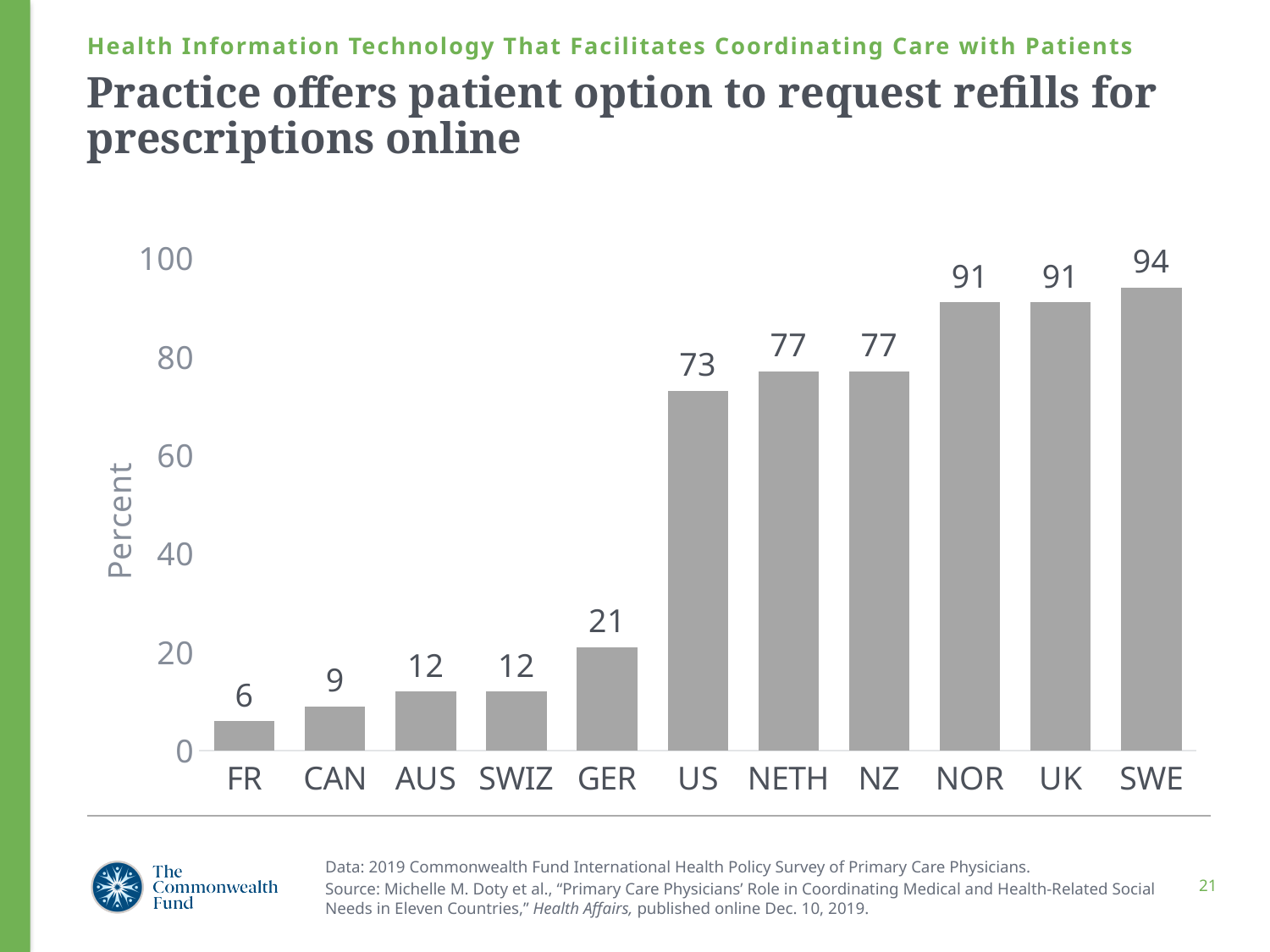
Which country has the lowest value? FR Which country has the highest value? SWE What is the value for US? 73 How many countries are shown on the x axis? 11 Is the value for NOR greater or less than 80? greater What is the difference between the values for SWE and FR? 88 What is the difference between the values for NETH and US? 4 What is the label on the y axis? Percent Which is larger, the value for CAN or the value for GER? GER What kind of chart is shown on the slide? bar chart What is the value for GER? 21 What is the value for FR? 6